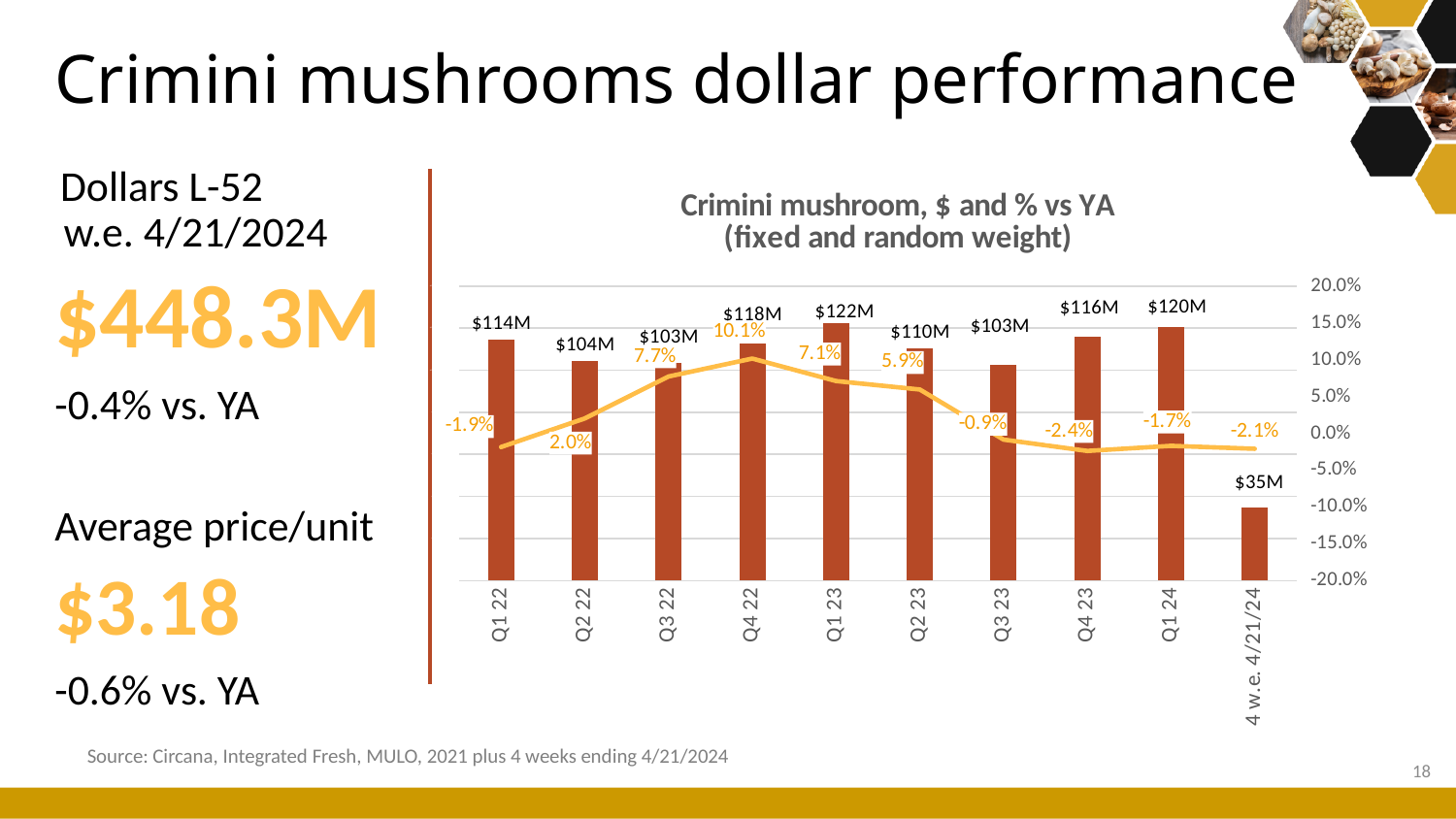
Does the % vs YA line rise or fall from Q4 22 to Q4 23? Fall Which quarter has the highest dollar value? Q1 23 Is the % vs YA value for Q3 22 greater or less than 5.0%? greater What is the dollar value for Q1 23? $122M Which is larger, the dollar value for Q4 22 or Q2 23? Q4 22 What is the difference in dollars between Q1 24 and Q4 23? $4M What is the % vs YA value for Q4 22? 10.1% Which period has the lowest % vs YA value? Q4 23 How many periods are shown on the x axis? 10 What is the dollar value for the 4 w.e. 4/21/24 period? $35M What kind of chart is this? Bar chart with a line What is the title of the chart? Crimini mushroom, $ and % vs YA (fixed and random weight)